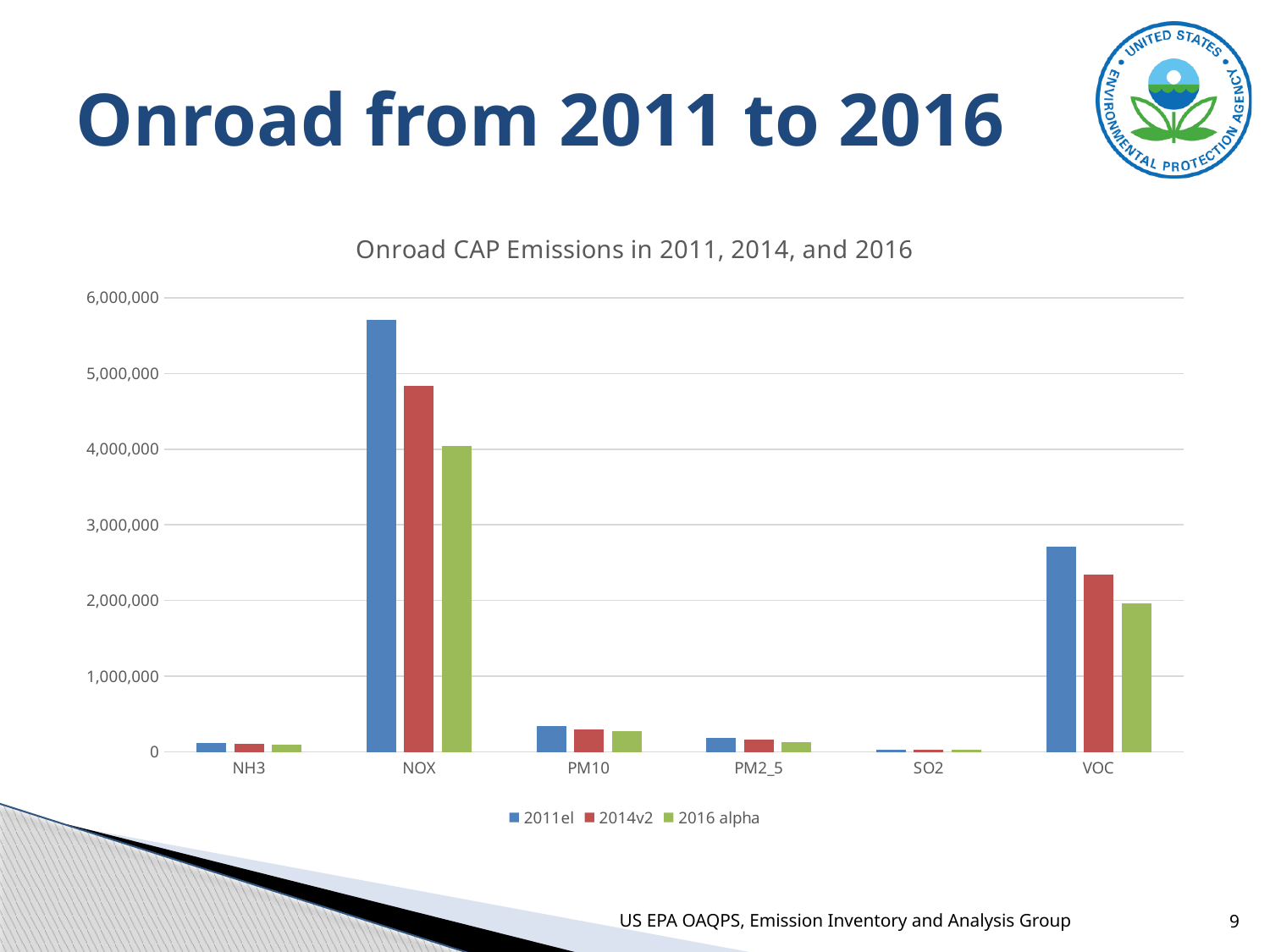
How many pollutant categories are shown on the x axis? 6 For NOX, do the values rise or fall from 2011el to 2014v2 to 2016 alpha? fall Which pollutant has the lowest emissions across all three series? SO2 Which pollutant has the highest 2011el emissions? NOX Is the 2011el value for VOC greater or less than 2,000,000? greater What is the title of the chart? Onroad CAP Emissions in 2011, 2014, and 2016 Which is larger, the 2011el value for NOX or the 2011el value for VOC? NOX Is the 2016 alpha value for NOX greater or less than 5,000,000? less Is the 2011el value for NOX greater or less than 5,000,000? greater What kind of chart is shown on the slide? bar chart How many series does the legend list? 3